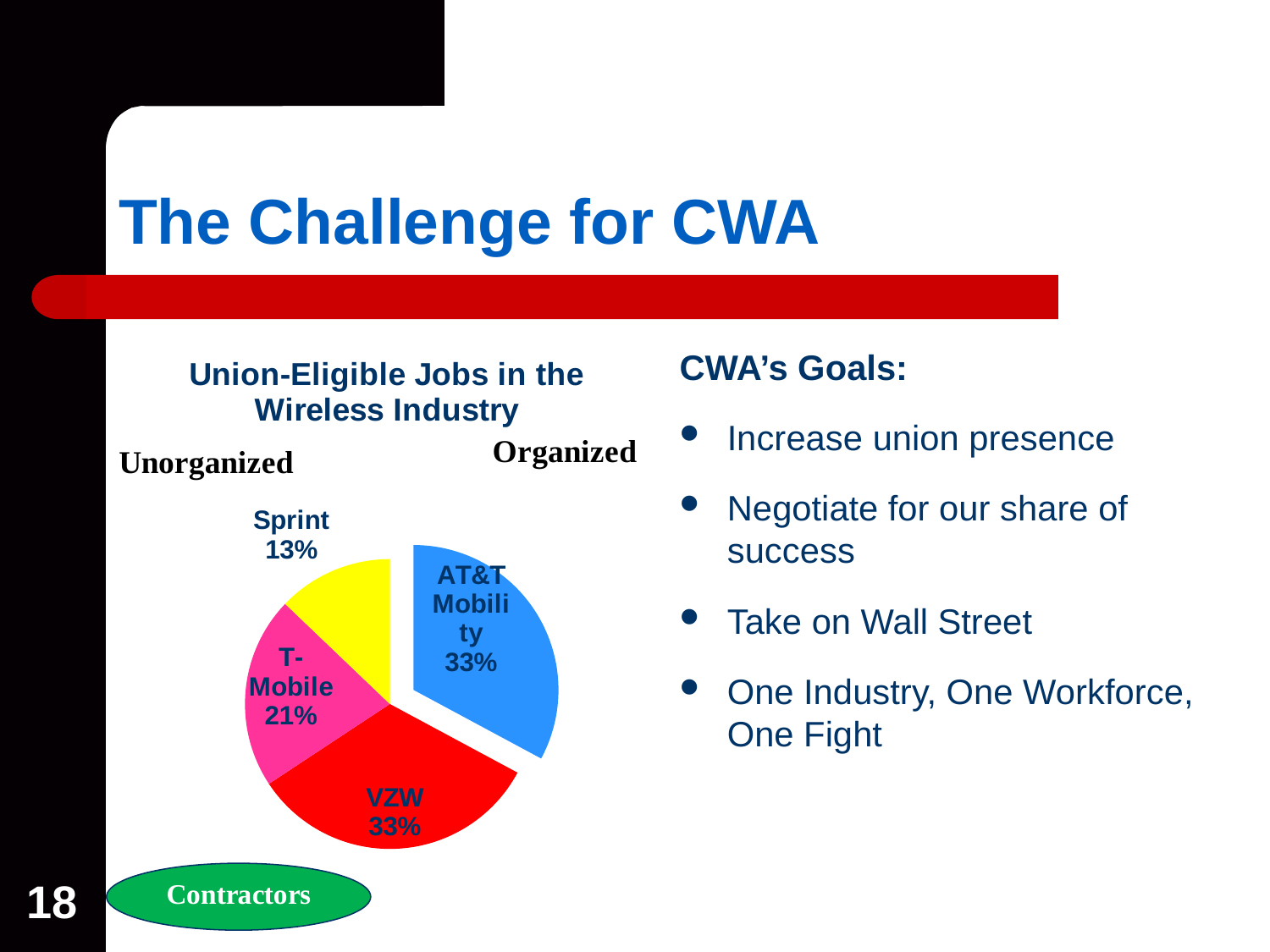
What is the title of the chart? Union-Eligible Jobs in the Wireless Industry What kind of chart is shown on the slide? pie chart What is the value shown for VZW? 33% What share of the pie does Sprint hold? 13% Which is larger, the share for T-Mobile or the share for Sprint? T-Mobile What is the value shown for T-Mobile? 21% Which slice of the pie is the smallest? Sprint What is the difference between the T-Mobile share and the Sprint share? 8% How many slices does the pie chart have? 4 Which slice is pulled out (exploded) from the rest of the pie? AT&T Mobility What is the difference between the VZW share and the T-Mobile share? 12% What is the value shown for AT&T Mobility? 33%